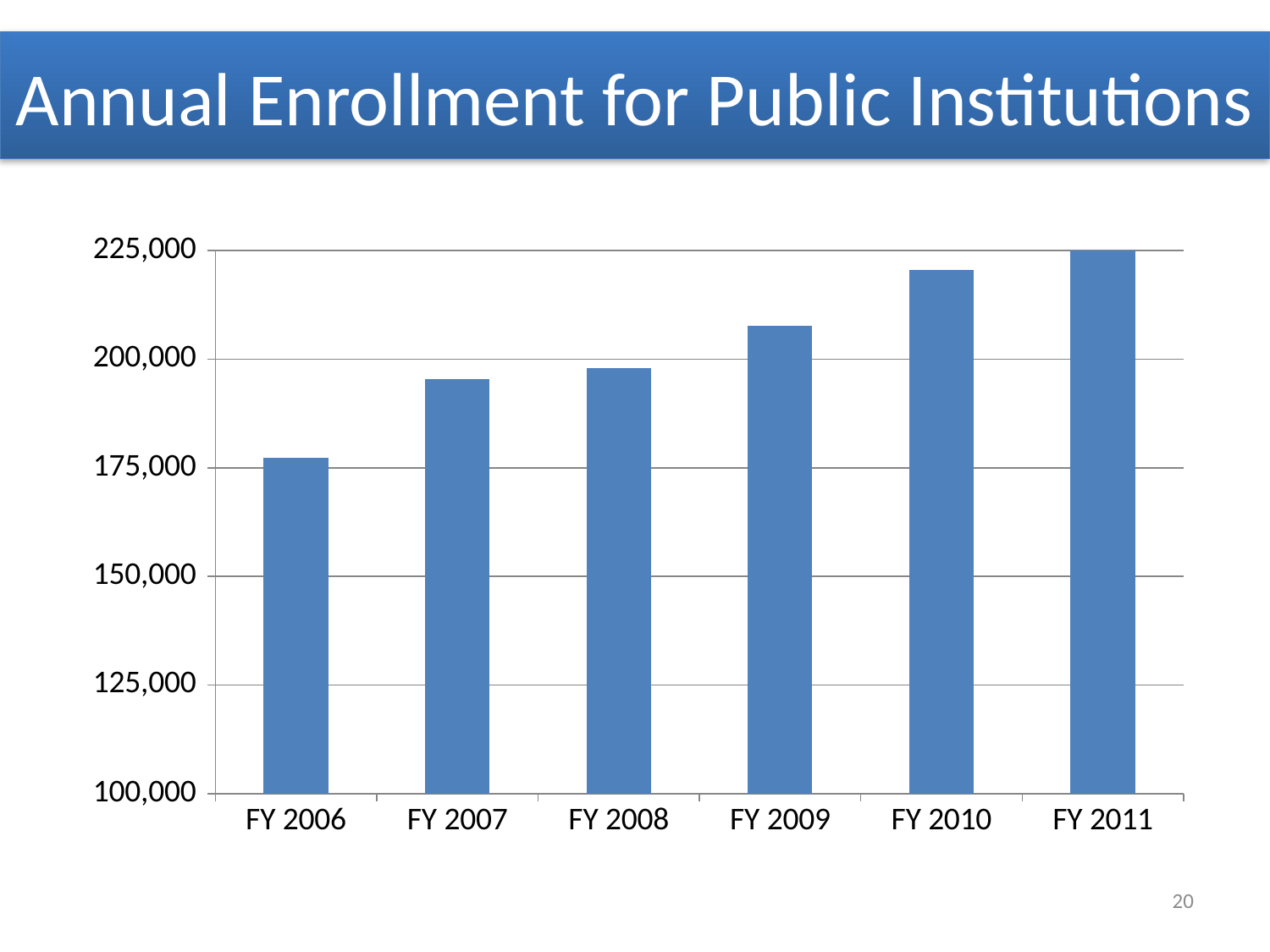
What kind of chart is shown on the slide? Bar chart Is the value for FY 2007 greater or less than 200,000? less What is the title of the chart? Annual Enrollment for Public Institutions Which is larger, the value for FY 2009 or the value for FY 2007? FY 2009 Which fiscal year has the lowest enrollment? FY 2006 Do enrollment values rise or fall from FY 2006 to FY 2011? Rise Which fiscal year has the highest enrollment? FY 2011 How many fiscal years are shown on the x axis? 6 Is the value for FY 2006 greater or less than 200,000? less Which is larger, the value for FY 2006 or the value for FY 2010? FY 2010 Is the value for FY 2010 greater or less than 200,000? greater